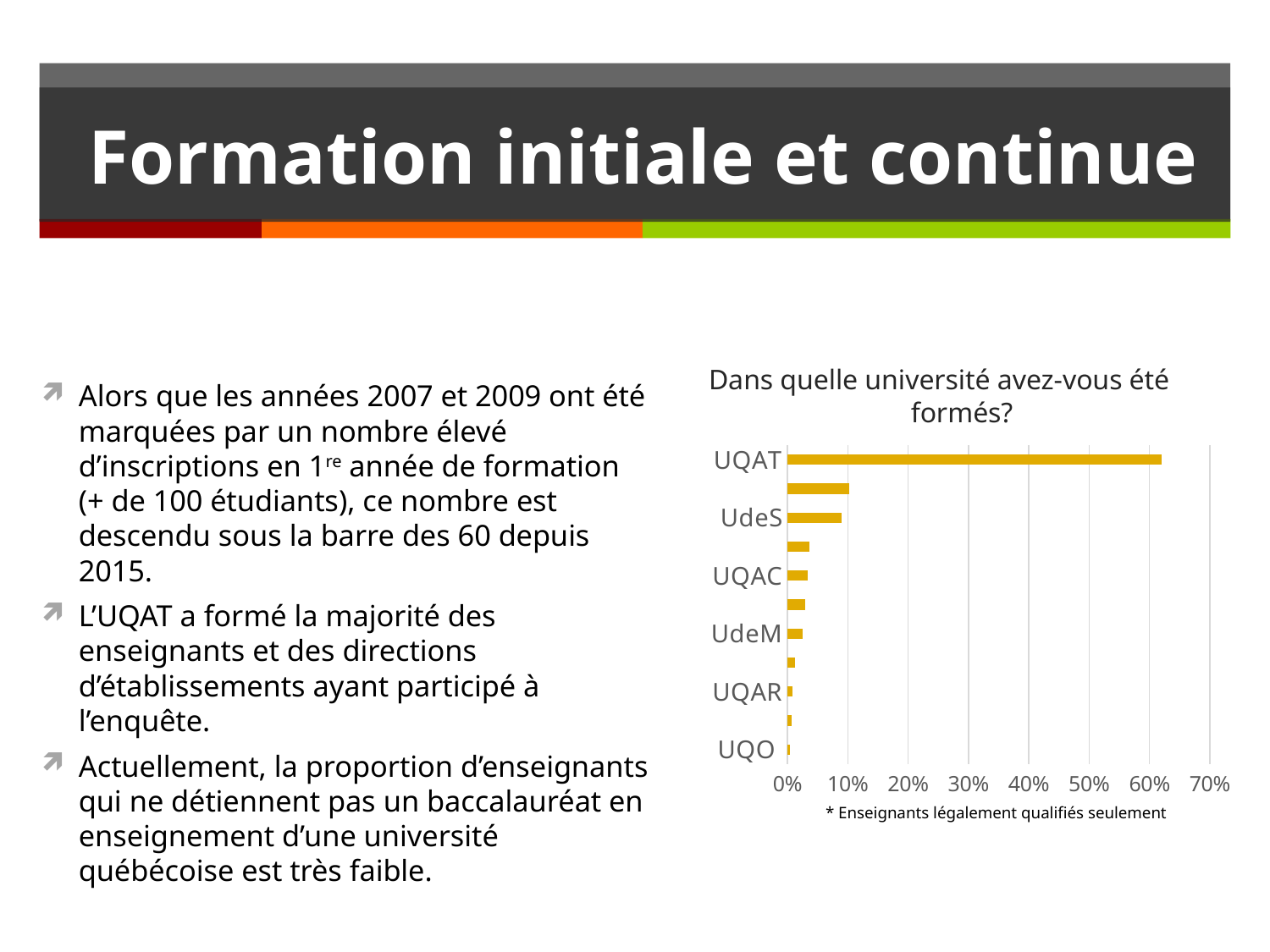
Is the value for UQAC greater or less than 10%? less Do the bar values increase or decrease going from the top of the chart to the bottom? decrease Which has a larger value, UdeS or UQAC? UdeS What is the title of the chart? Dans quelle université avez-vous été formés? Is the value for UQAT greater or less than 50%? greater How many bars are plotted in the chart? 11 What is the highest value shown on the chart's horizontal axis? 70% What kind of chart is shown on the slide? Bar chart Which has a larger value, UdeM or UQO? UdeM Which university has the highest value in the chart? UQAT Is the value for UdeS greater or less than 10%? less Which has a larger value, UQAT or UdeS? UQAT